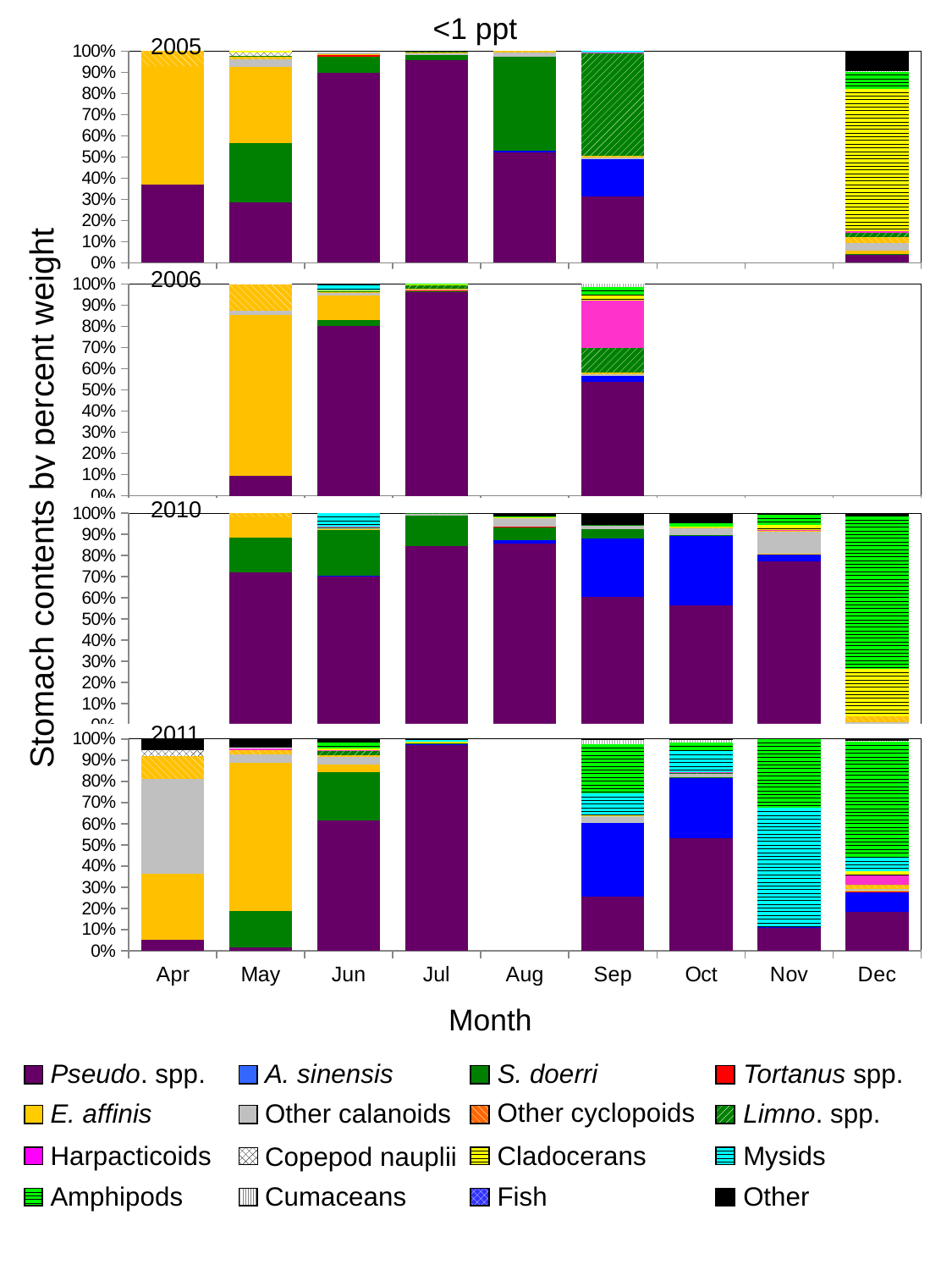
How many series does the legend list? 16 In the 2005 panel, how many months have a bar plotted? 7 How many months are labelled on the x axis? 9 What is the title shown above the charts? <1 ppt In the 2010 panel, is the Amphipods share for Dec greater or less than 60%? greater In the 2006 panel, how many months have a bar plotted? 4 In the 2006 panel, is the E. affinis share for May greater or less than 70%? greater In the 2011 panel, which month has the largest Pseudo. spp. share? Jul In the 2005 panel, is the Pseudo. spp. share for Jul greater or less than 90%? greater What kind of chart is used in each of the four panels on the slide? Stacked bar chart In the 2005 panel for Apr, which is larger: the Pseudo. spp. share or the E. affinis share? E. affinis